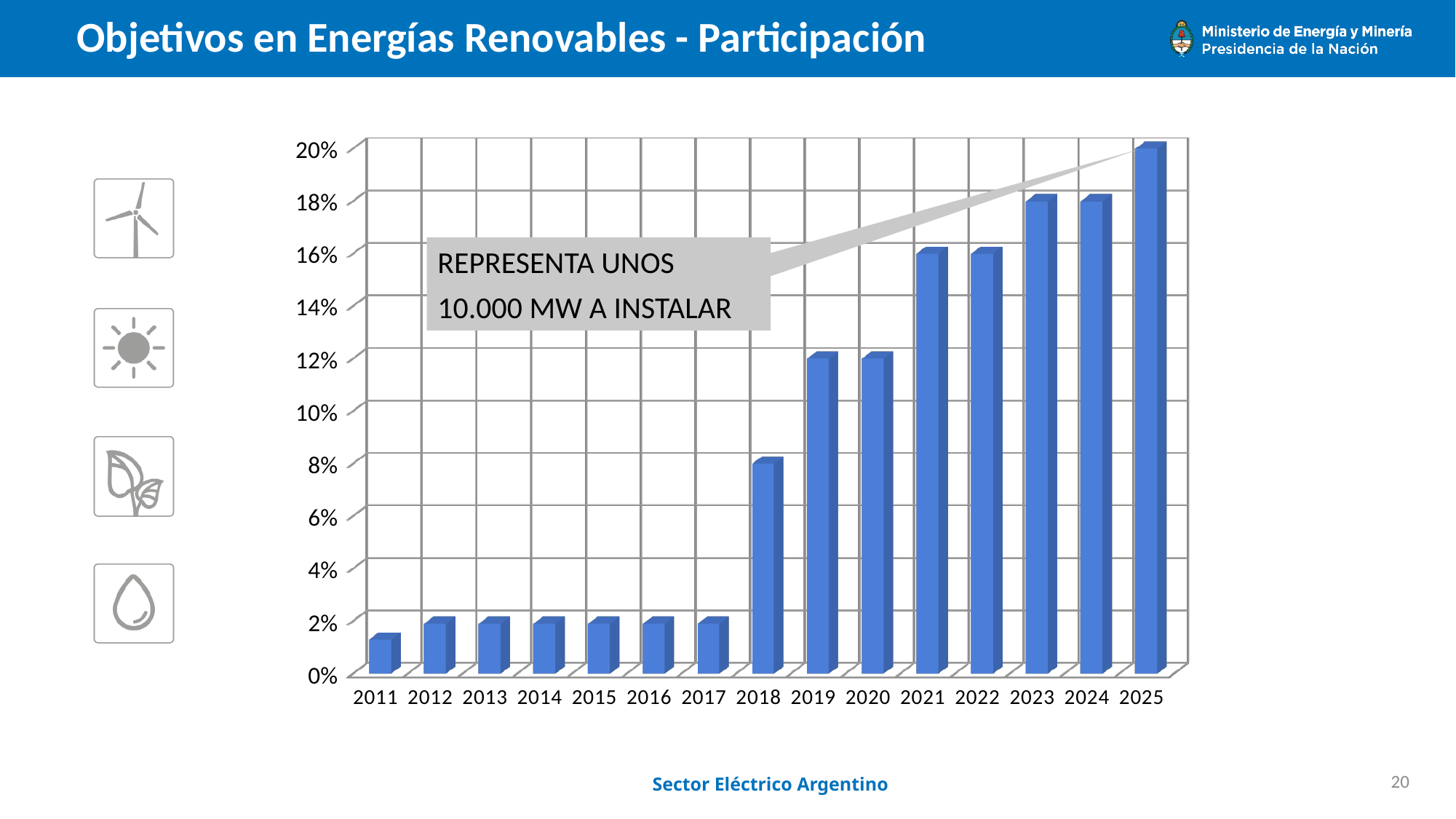
What is the value for 2025 in the chart? 20% Is the value for 2021 greater or less than 14%? greater What is the value for 2018 in the chart? 8% Do the values generally rise or fall from 2011 to 2025? rise Is the value for 2019 greater or less than 10%? greater How many years are shown on the x axis of the chart? 15 Which year has the highest bar in the chart? 2025 Is the value for 2011 greater or less than 2%? less What kind of chart is shown on the slide? bar chart Which year has the lowest bar in the chart? 2011 What does the callout box on the chart say? REPRESENTA UNOS 10.000 MW A INSTALAR Which is larger, the value for 2019 or the value for 2023? 2023